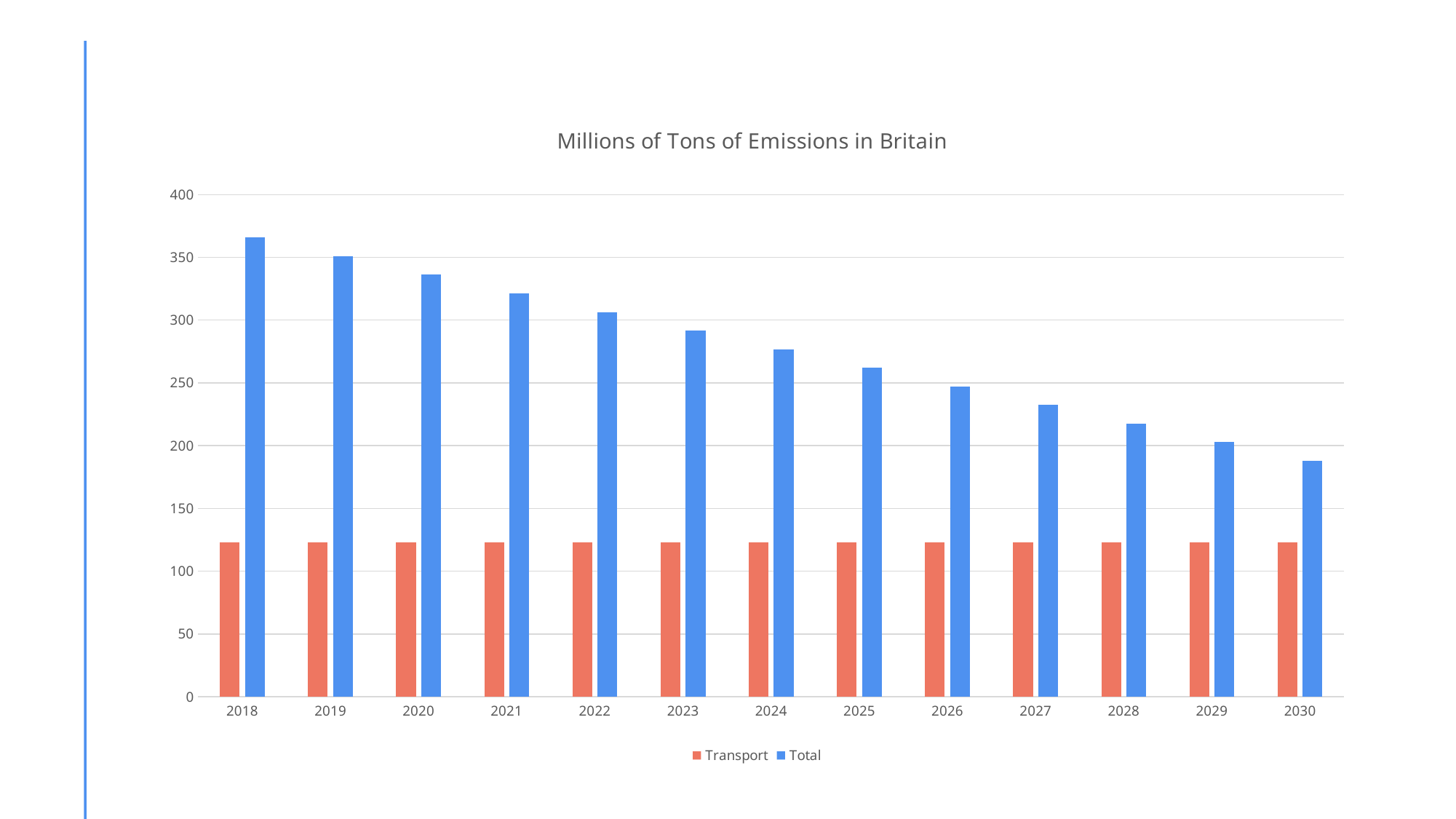
Is the Total value for 2030 greater or less than 200? less What is the title of the chart? Millions of Tons of Emissions in Britain Which is larger in 2030, the Transport value or the Total value? Total Is the Total value for 2018 greater or less than 350? greater How many years are shown along the x axis? 13 In which year is the Total series lowest? 2030 Do the Total values rise or fall from 2018 to 2030? fall Is the Total value for 2021 greater or less than 300? greater What kind of chart is shown on the slide? bar chart How many series does the legend list? 2 In which year is the Total series highest? 2018